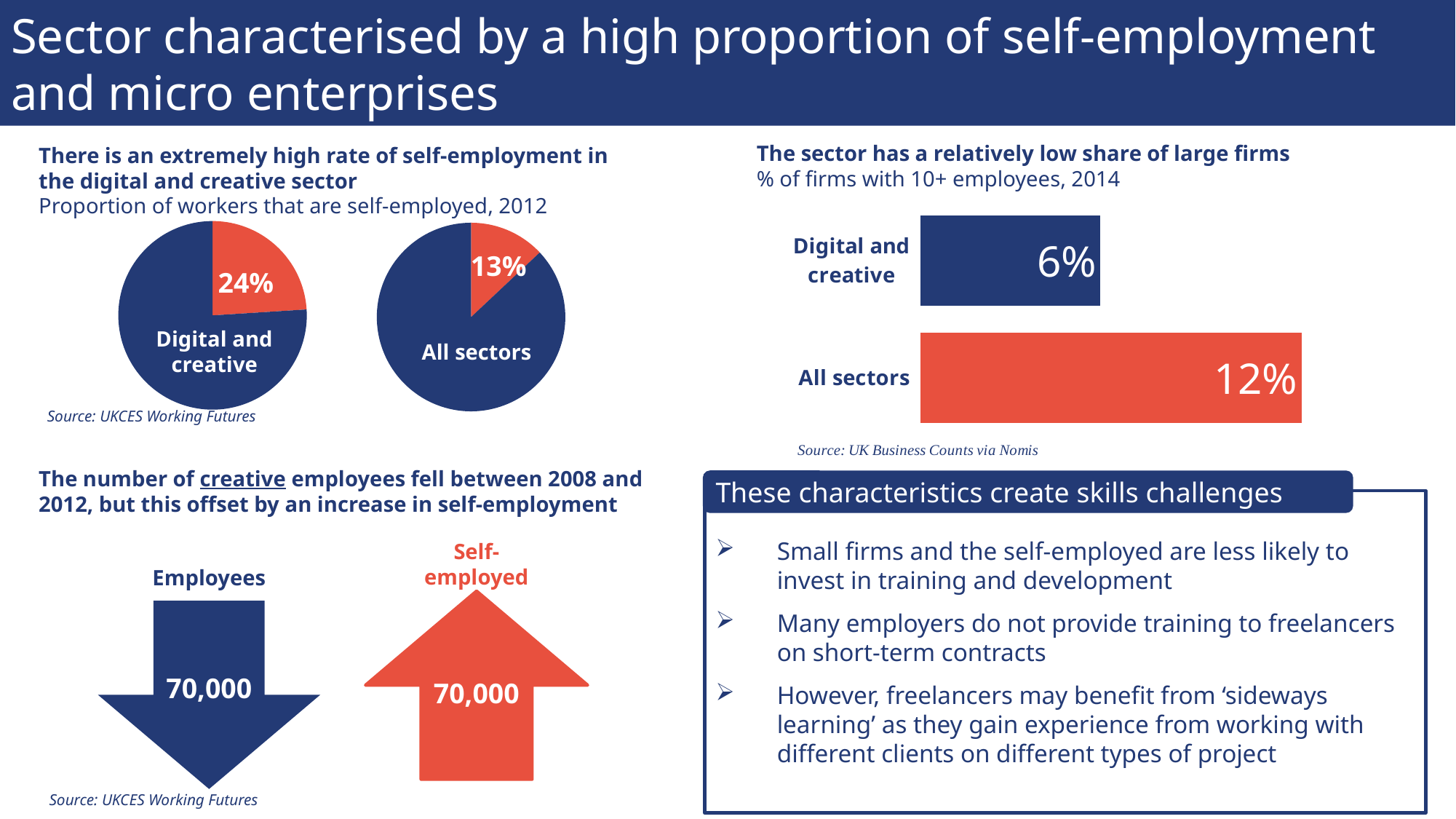
In the chart titled 'The sector has a relatively low share of large firms', which category has the higher value? All sectors In the chart titled 'The sector has a relatively low share of large firms', what is the value for All sectors? 12% In the arrow graphic at the bottom left of the slide, by how much did the number of creative employees fall between 2008 and 2012? 70,000 In the pie charts showing the proportion of workers that are self-employed in 2012, what share is self-employed across All sectors? 13% In the pie charts showing the proportion of workers that are self-employed in 2012, how many percentage points higher is the Digital and creative share than the All sectors share? 11 percentage points In the pie charts showing the proportion of workers that are self-employed in 2012, which has the larger self-employed share: Digital and creative or All sectors? Digital and creative How many pie charts are shown under the heading about the proportion of workers that are self-employed, 2012? 2 In the chart titled 'The sector has a relatively low share of large firms', what colour is the All sectors bar? Red What kind of chart is used under the heading 'The sector has a relatively low share of large firms'? Bar chart In the chart titled 'The sector has a relatively low share of large firms', what is the difference between the All sectors value and the Digital and creative value? 6 percentage points In the chart titled 'The sector has a relatively low share of large firms', what is the value for Digital and creative? 6% In the pie charts showing the proportion of workers that are self-employed in 2012, what share is self-employed in the Digital and creative sector? 24%